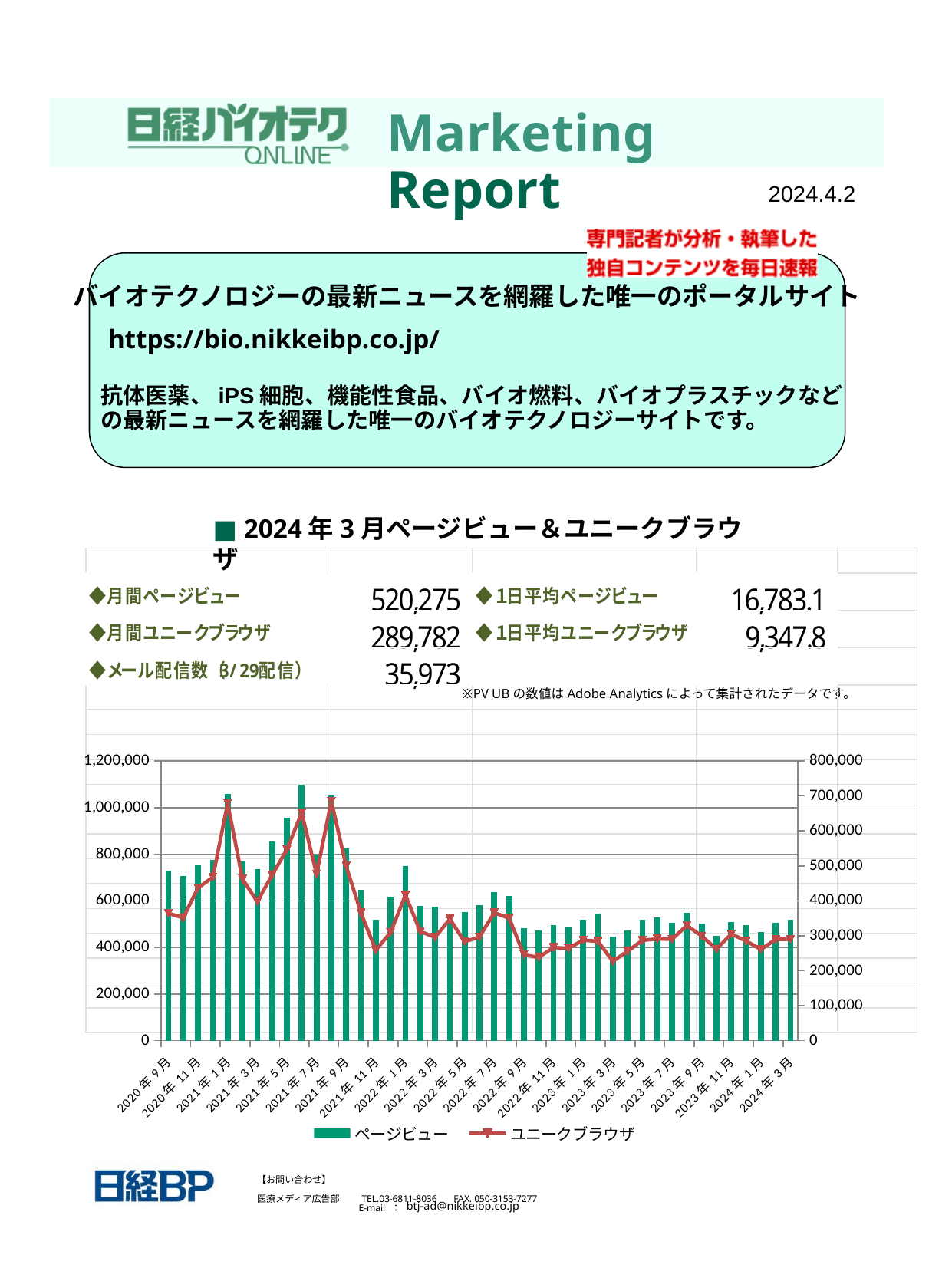
Is the ページビュー value for 2024年3月 greater or less than 400,000? greater Which has the larger ページビュー value, 2021年1月 or 2022年1月? 2021年1月 Is the ページビュー value for 2021年7月 greater or less than 1,000,000? less Is the ユニークブラウザ value for 2023年3月 greater or less than 300,000 on the right axis? less How many series does the chart legend list? 2 What colour is the ユニークブラウザ line in the chart? Red Do the ページビュー values generally rise or fall from 2021年7月 to 2024年3月? fall In which month is the ページビュー bar highest? 2021年6月 What kind of chart is shown on the slide? A combined bar and line chart Which series is drawn as bars in the chart? ページビュー